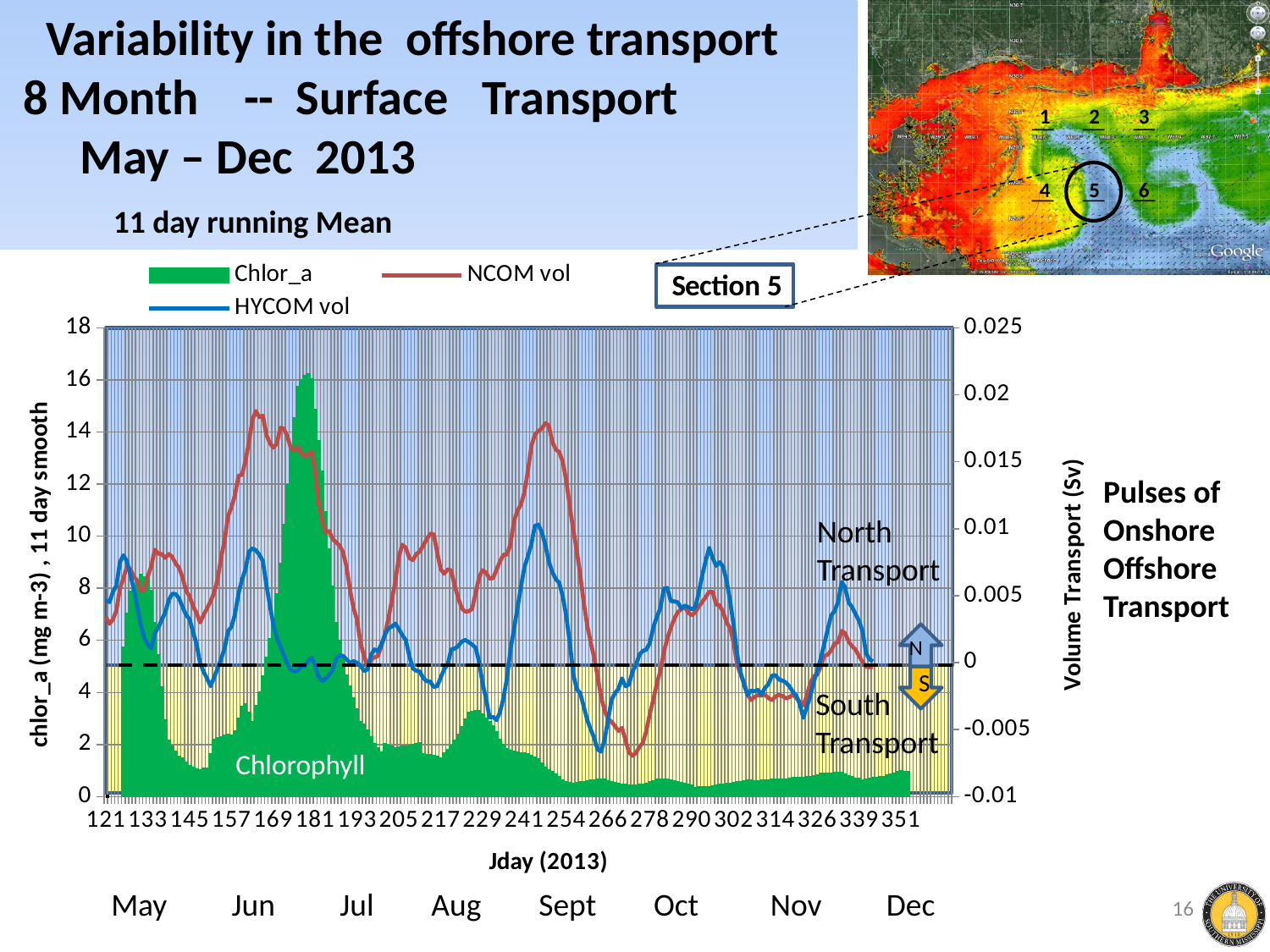
Is the HYCOM vol value at Jday 266 greater or less than 0 Sv? less How many series does the chart legend list? 3 Does the chlorophyll value rise or fall from Jday 181 to Jday 205? fall What is the title of the right-hand vertical axis? Volume Transport (Sv) What kind of chart is shown on the slide? A combination chart of bars (Chlor_a) and lines (NCOM vol, HYCOM vol) Is the chlorophyll value at Jday 351 greater or less than 2 mg m-3? less Which series reaches the higher peak volume transport, NCOM vol or HYCOM vol? NCOM vol What is the maximum value shown on the right-hand Volume Transport axis? 0.025 Is the peak chlorophyll value greater or less than 14 mg m-3? greater How many Jday tick labels are shown on the x axis? 20 Which series is plotted as green bars? Chlor_a